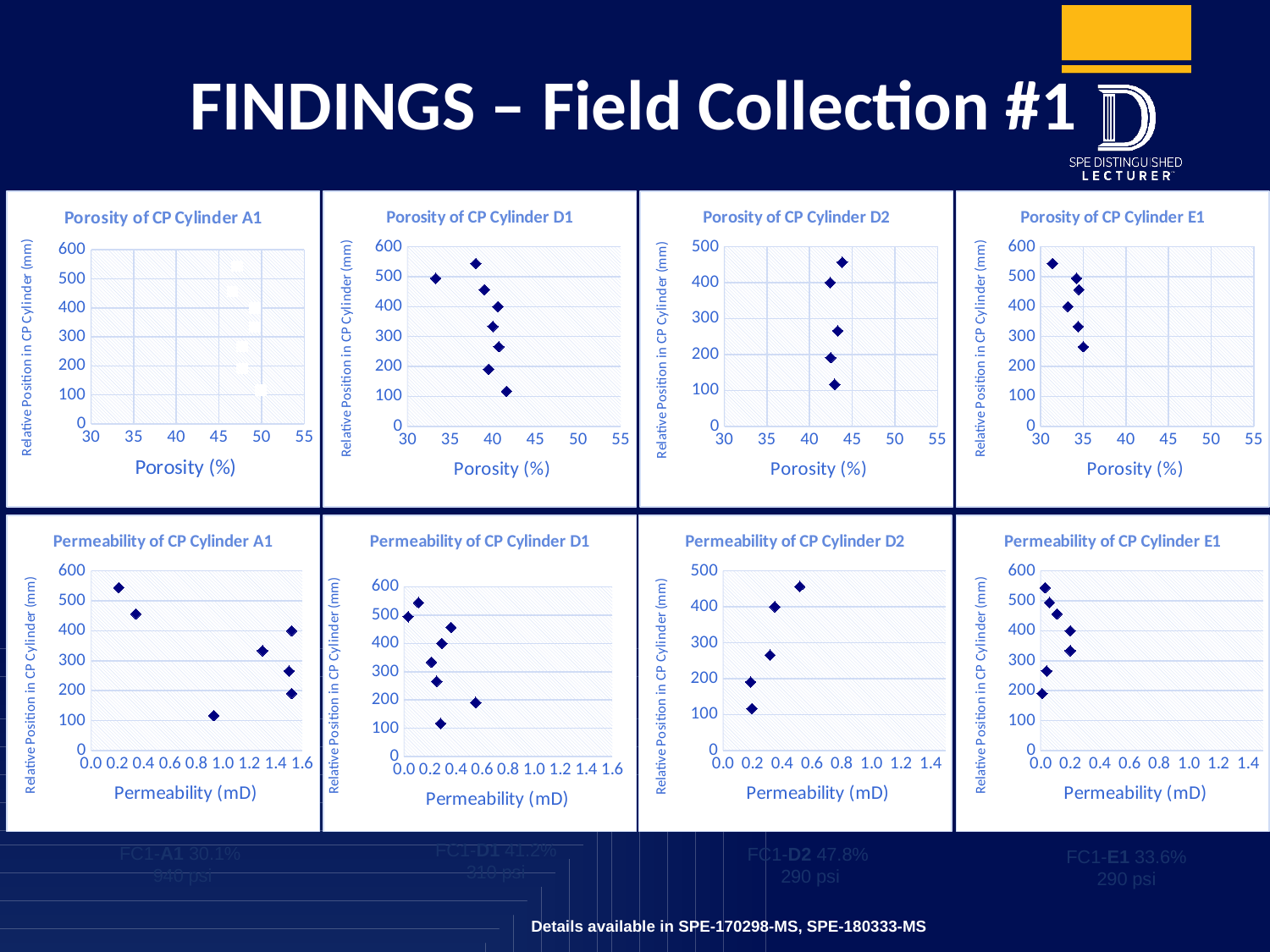
In the Permeability of CP Cylinder D2 chart, is the permeability of the point at 455 mm greater or less than 1.0? less What kind of chart is the Porosity of CP Cylinder D1 chart? Scatter chart In the Porosity of CP Cylinder D2 chart, is the porosity of the point at 455 mm greater or less than 40? greater In the Permeability of CP Cylinder D2 chart, does permeability rise or fall as relative position increases? rise What is the x-axis title of the Permeability of CP Cylinder A1 chart? Permeability (mD) How many data points are plotted in the Porosity of CP Cylinder D1 chart? 8 How many data points are plotted in the Permeability of CP Cylinder D2 chart? 5 What is the highest tick value on the y-axis of the Porosity of CP Cylinder D2 chart? 500 In the Porosity of CP Cylinder E1 chart, is the porosity of the point at 265 mm greater or less than 40? less How many data points are plotted in the Porosity of CP Cylinder E1 chart? 6